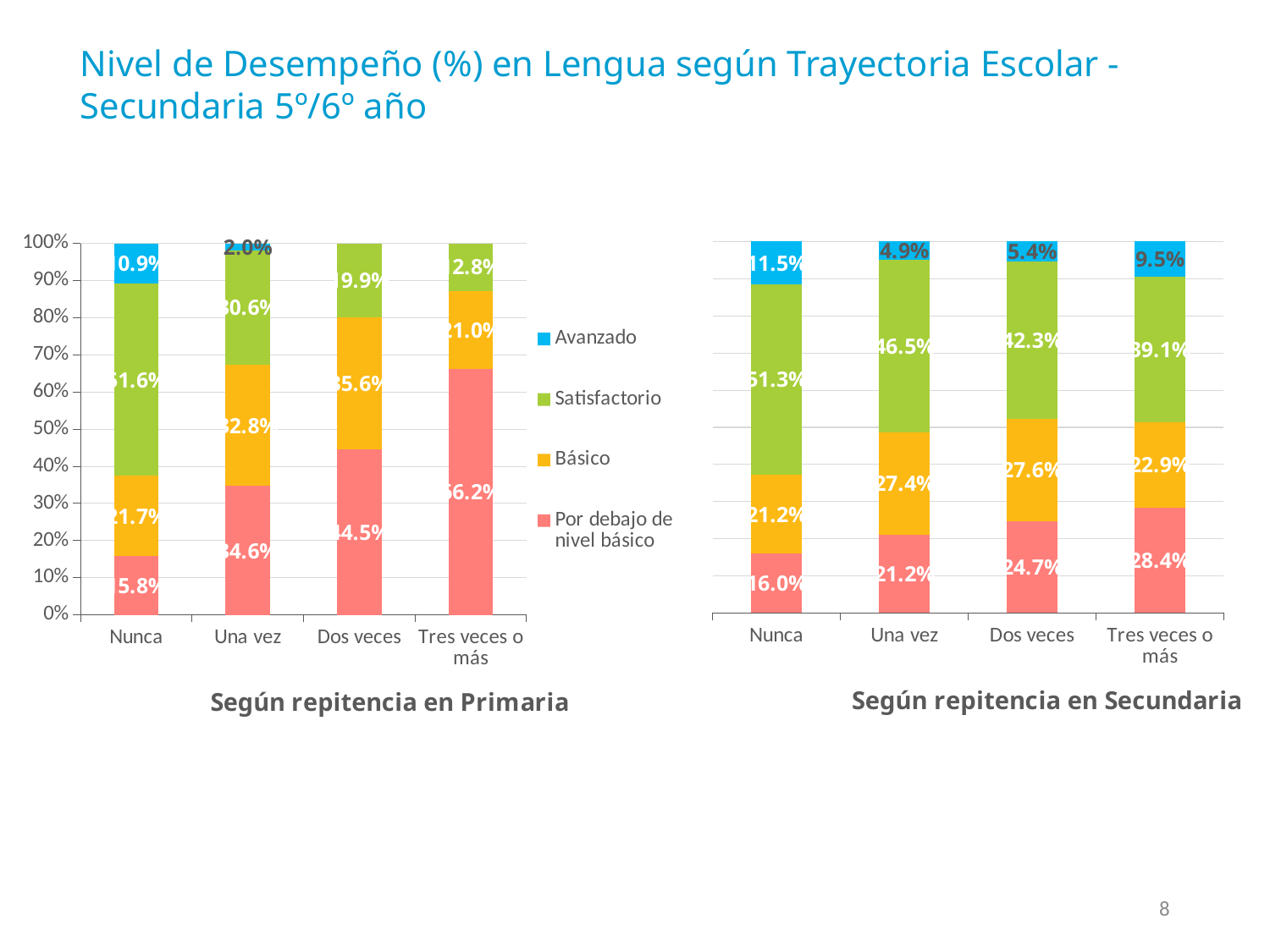
What is the title of the chart on the right side of the slide? Según repitencia en Secundaria What kind of chart is used on this slide? Stacked bar chart In the 'Según repitencia en Secundaria' chart, which category has the highest 'Por debajo de nivel básico' value? Tres veces o más How many series does the legend list? 4 In the 'Según repitencia en Secundaria' chart, does the 'Por debajo de nivel básico' value rise or fall from Nunca to 'Tres veces o más'? Rise In the 'Según repitencia en Secundaria' chart, what is the Satisfactorio value for 'Una vez'? 46.5% In the 'Según repitencia en Secundaria' chart, what is the 'Por debajo de nivel básico' value for 'Tres veces o más'? 28.4% In the 'Según repitencia en Primaria' chart, what is the Avanzado value for 'Una vez'? 2.0% In the 'Según repitencia en Secundaria' chart, how many categories are shown on the x axis? 4 In the 'Según repitencia en Secundaria' chart, what is the difference between the Avanzado values for Nunca and 'Tres veces o más'? 2.0 percentage points In the 'Según repitencia en Secundaria' chart, which is larger: the Satisfactorio value for Nunca or for 'Tres veces o más'? Nunca In the 'Según repitencia en Secundaria' chart, what is the Avanzado value for Nunca? 11.5%